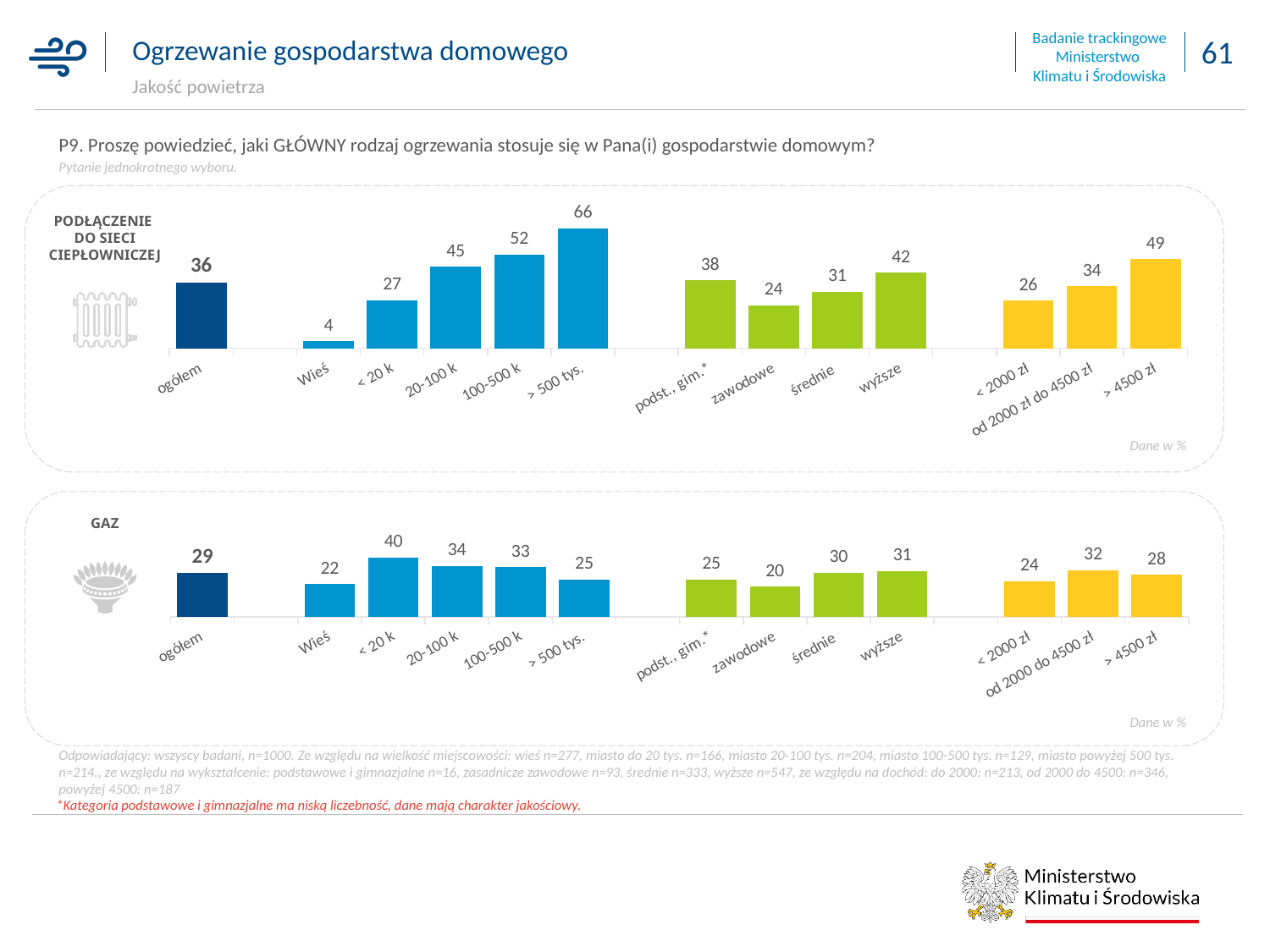
In the 'GAZ' chart, what is the difference between the values for 'wyższe' and 'zawodowe'? 11 In the 'PODŁĄCZENIE DO SIECI CIEPŁOWNICZEJ' chart, which category has the lowest value? Wieś In the 'GAZ' chart, which category has the lowest value? zawodowe In the 'GAZ' chart, which is larger: the value for 'od 2000 do 4500 zł' or the value for '< 2000 zł'? od 2000 do 4500 zł What type of chart is the 'PODŁĄCZENIE DO SIECI CIEPŁOWNICZEJ' chart? bar chart In the 'GAZ' chart, what is the value for 'ogółem'? 29 In the 'PODŁĄCZENIE DO SIECI CIEPŁOWNICZEJ' chart, do the values rise or fall from 'Wieś' to '> 500 tys.'? rise How many categories are plotted in the 'GAZ' chart? 13 In the 'GAZ' chart, what is the value for '< 20 k'? 40 In the 'PODŁĄCZENIE DO SIECI CIEPŁOWNICZEJ' chart, what is the difference between the values for '> 4500 zł' and '< 2000 zł'? 23 In the 'PODŁĄCZENIE DO SIECI CIEPŁOWNICZEJ' chart, which category has the highest value? > 500 tys. In the 'PODŁĄCZENIE DO SIECI CIEPŁOWNICZEJ' chart, what is the value for 'ogółem'? 36